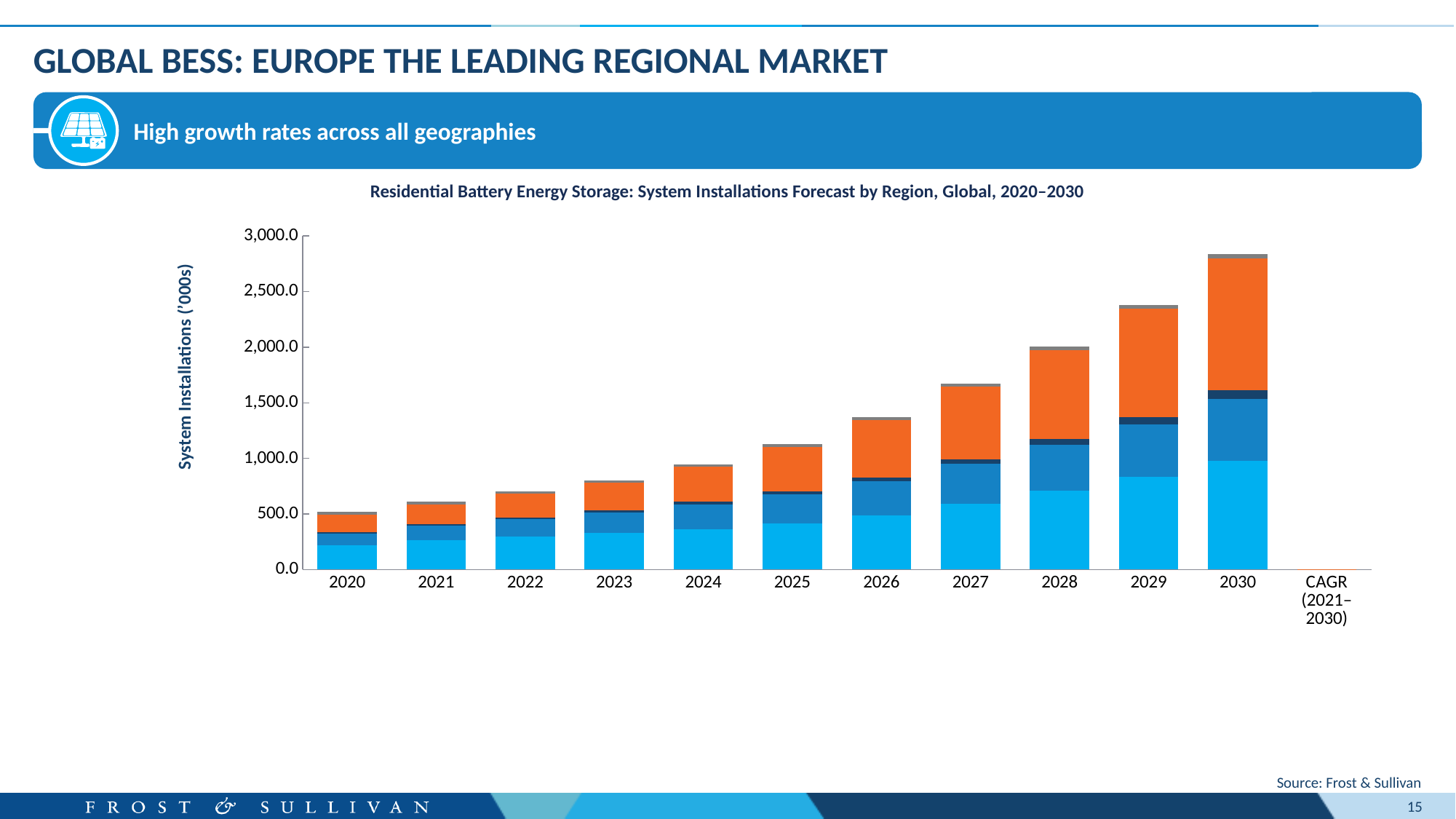
What kind of chart is shown on the slide? Stacked bar chart Is the total stacked bar for 2020 greater or less than 1,000.0? less What is the label on the vertical axis of the chart? System Installations ('000s) How many years are plotted as bars in the chart? 11 Which year has the shortest stacked bar? 2020 What is the title of the chart? Residential Battery Energy Storage: System Installations Forecast by Region, Global, 2020–2030 Is the total stacked bar for 2030 greater or less than 2,500.0? greater Is the total stacked bar for 2027 greater or less than 1,500.0? greater Which year has the tallest stacked bar? 2030 Which year has the larger total stacked bar, 2026 or 2029? 2029 Do total system installations rise or fall from 2020 to 2030? Rise